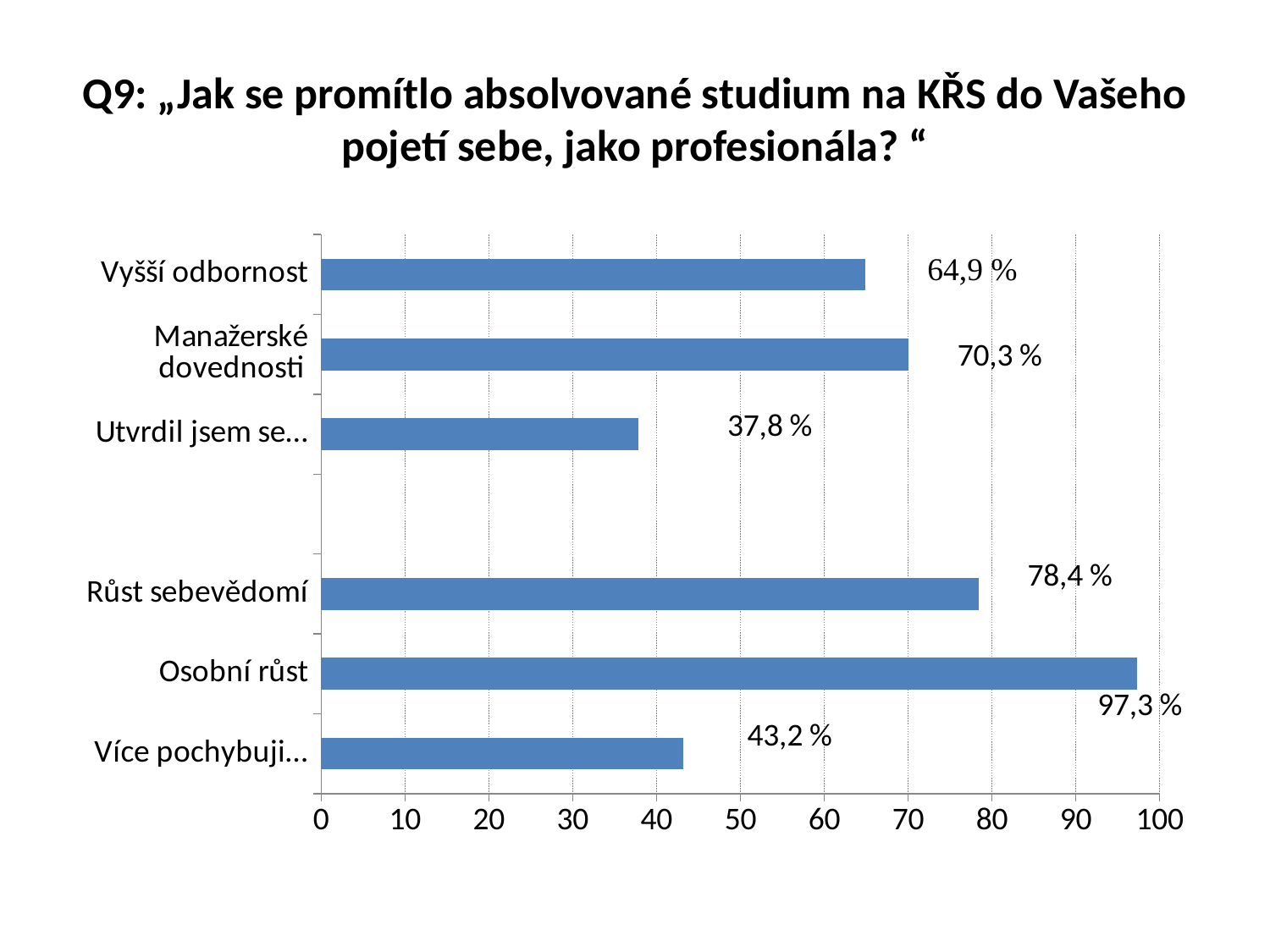
What is the value for Osobní růst? 97,3 % What is the value for Manažerské dovednosti? 70,3 % What is the difference between the values for Osobní růst and Růst sebevědomí? 18,9 % What is the difference between the values for Manažerské dovednosti and Vyšší odbornost? 5,4 % Is the value for Více pochybuji… greater or less than 50? less Which is larger, the value for Růst sebevědomí or the value for Manažerské dovednosti? Růst sebevědomí Which category has the highest value? Osobní růst Which category has the lowest value? Utvrdil jsem se… What is the value for Růst sebevědomí? 78,4 % What kind of chart is shown on the slide? bar chart How many bars are plotted in the chart? 6 What is the value for Vyšší odbornost? 64,9 %